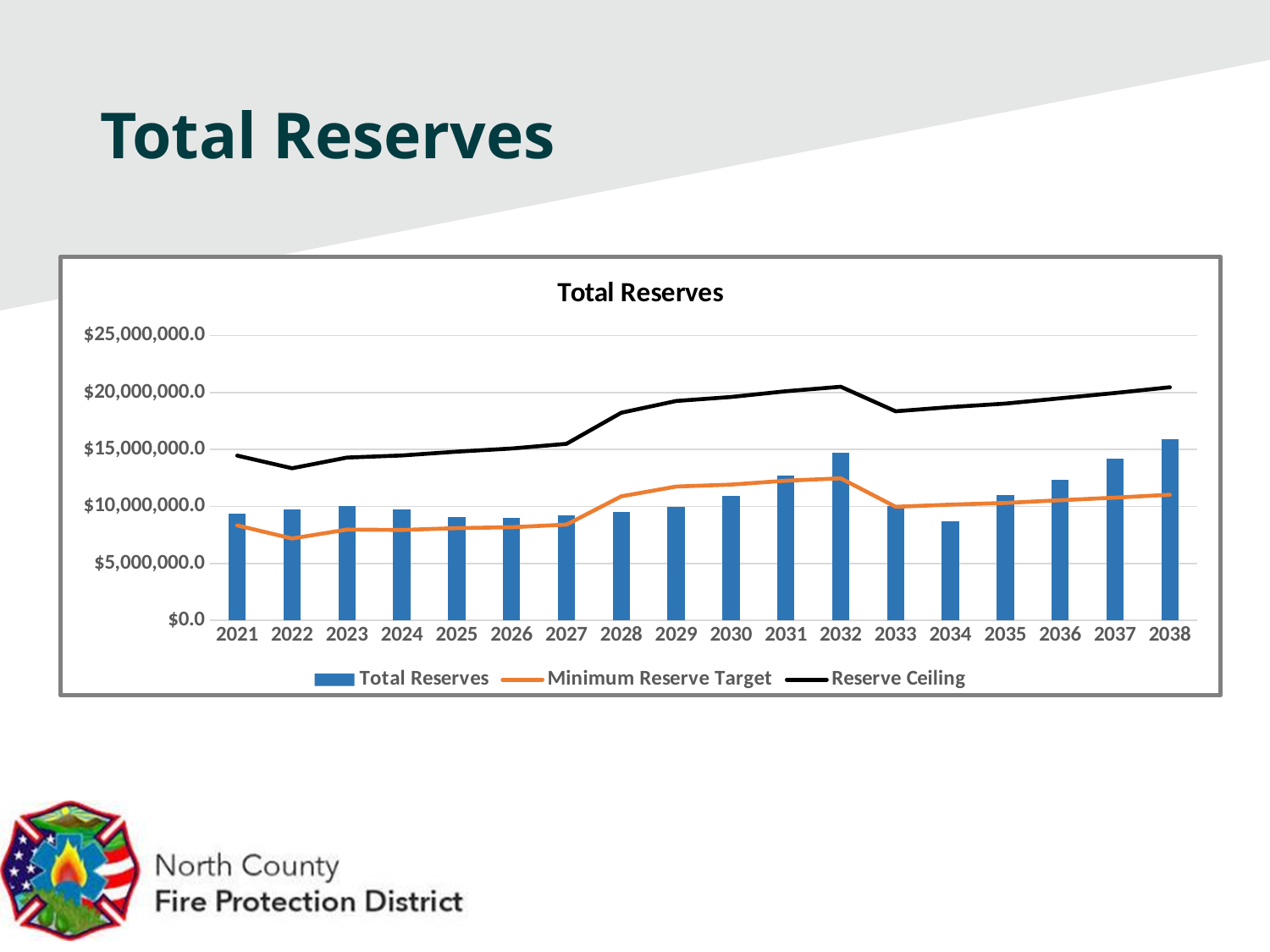
Which year has the lowest Total Reserves bar? 2034 Is the Total Reserves value for 2034 greater or less than $10,000,000.0? less Which year has the highest Total Reserves bar? 2038 What kind of chart is shown on the slide? A combination bar and line chart Is the Total Reserves value for 2038 greater or less than $15,000,000.0? greater Is the Minimum Reserve Target value for 2022 greater or less than $10,000,000.0? less Which year has the larger Total Reserves bar, 2032 or 2033? 2032 How many years are shown on the x axis? 18 How many series does the legend list? 3 Does the Reserve Ceiling line rise or fall from 2033 to 2038? Rises Which series is drawn as a black line in the legend? Reserve Ceiling